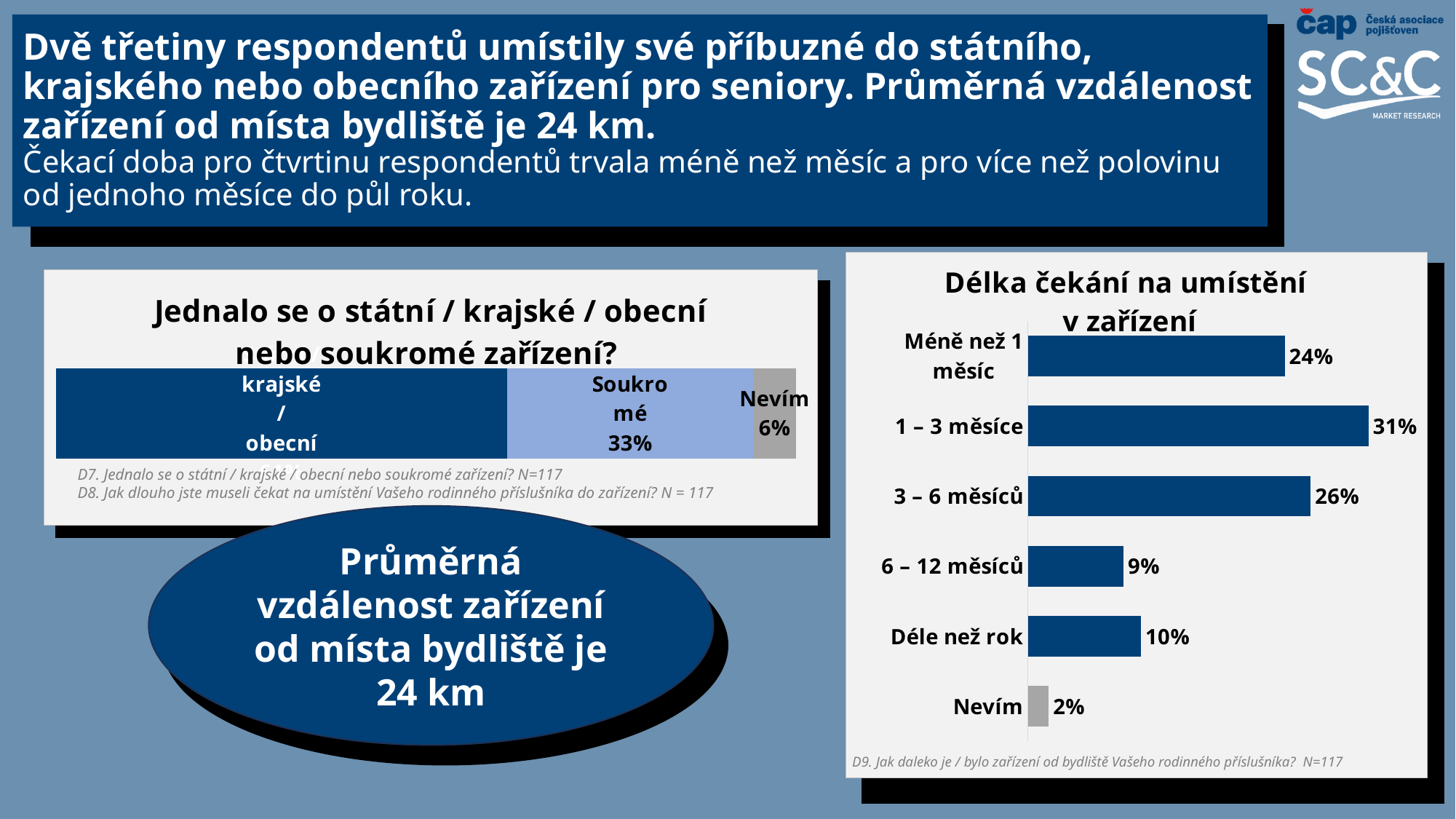
In the chart 'Délka čekání na umístění v zařízení', what is the value for 'Méně než 1 měsíc'? 24% In the chart 'Délka čekání na umístění v zařízení', what is the value for '6 – 12 měsíců'? 9% In the chart 'Jednalo se o státní / krajské / obecní nebo soukromé zařízení?', what is the value for 'Nevím'? 6% In the chart 'Délka čekání na umístění v zařízení', what is the difference between '3 – 6 měsíců' and 'Déle než rok'? 16% What kind of chart is 'Délka čekání na umístění v zařízení'? Bar chart How many categories are shown in the chart 'Délka čekání na umístění v zařízení'? 6 In the chart 'Délka čekání na umístění v zařízení', which is larger: 'Méně než 1 měsíc' or '3 – 6 měsíců'? 3 – 6 měsíců In the chart 'Délka čekání na umístění v zařízení', which bar is coloured grey rather than dark blue? Nevím In the chart 'Délka čekání na umístění v zařízení', which category has the highest value? 1 – 3 měsíce In the chart 'Délka čekání na umístění v zařízení', which category has the lowest value? Nevím In the chart 'Délka čekání na umístění v zařízení', what is the value for '1 – 3 měsíce'? 31% In the chart 'Jednalo se o státní / krajské / obecní nebo soukromé zařízení?', what is the value for 'Soukromé'? 33%